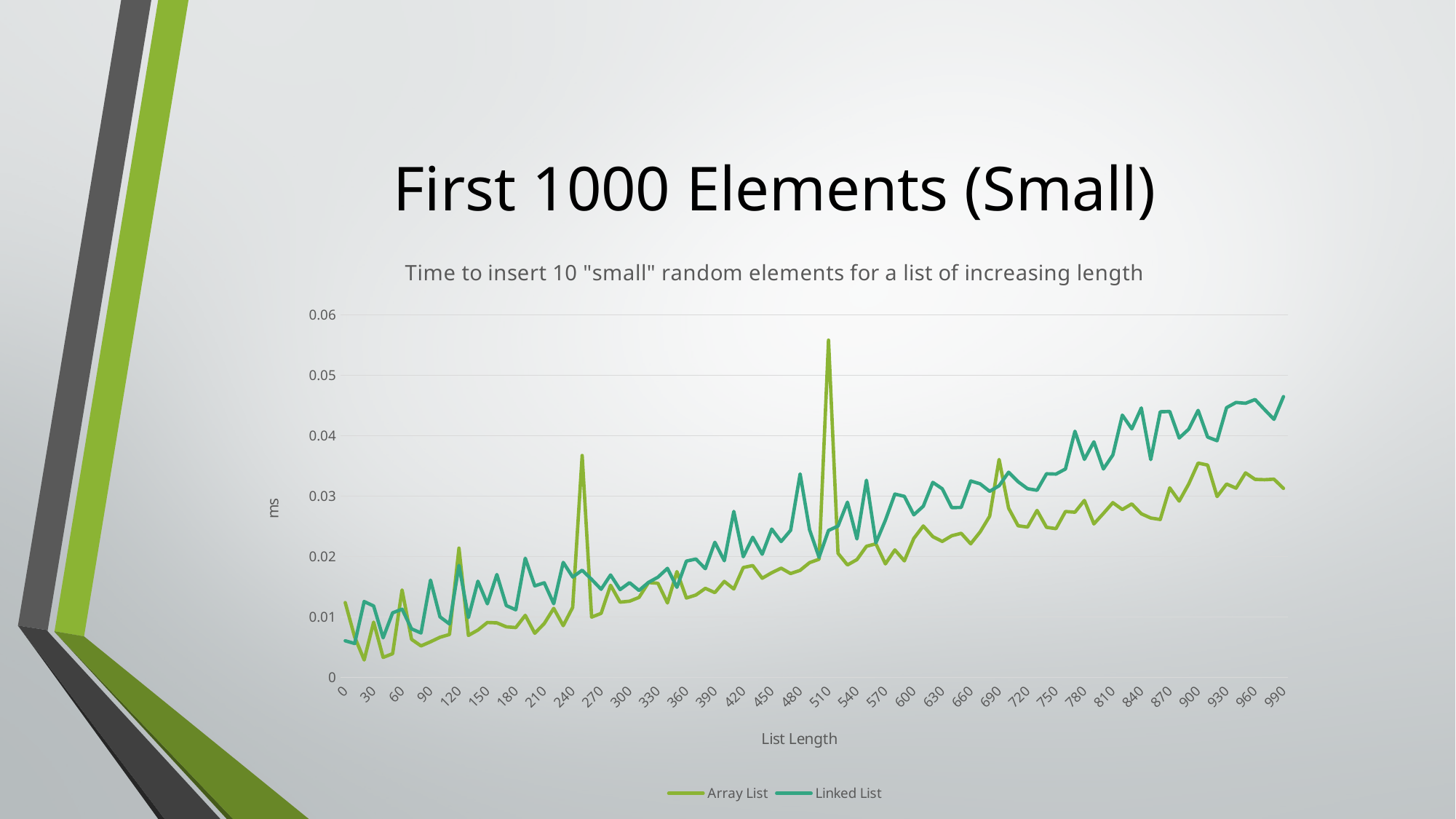
What kind of chart is shown on the slide? line chart Do the Linked List values generally rise or fall as list length increases? rise Is the value for Array List at list length 990 greater or less than 0.04? less Which series reaches the highest value anywhere on the chart? Array List Is the value for Linked List at list length 990 greater or less than 0.04? greater How many tick labels are shown on the x axis? 34 What is the label of the x axis? List Length What is the title of the chart? Time to insert 10 "small" random elements for a list of increasing length At list length 990, which series has the larger value, Array List or Linked List? Linked List Is the peak value of the Array List series near list length 510 greater or less than 0.05? greater How many series does the legend list? 2